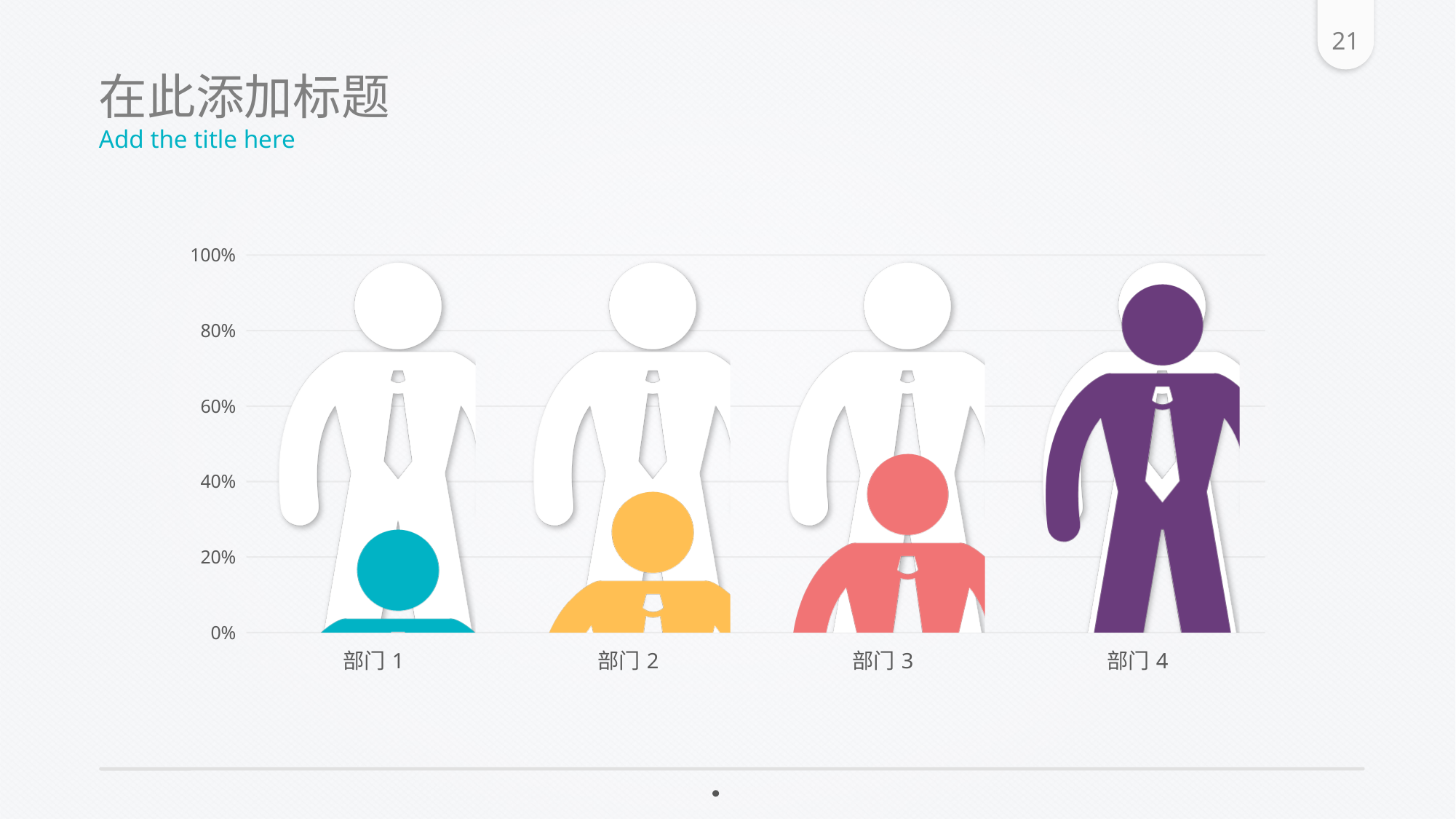
Is the value for 部门 3 greater or less than 20%? greater Which has the larger value, 部门 4 or 部门 2? 部门 4 What colour is the filled figure for 部门 4? purple Is the value for 部门 4 greater or less than 80%? greater Which category has the highest value in the chart? 部门 4 Is the value for 部门 2 greater or less than 60%? less Which category has the lowest value in the chart? 部门 1 How many categories are shown on the x axis of the chart? 4 What kind of chart is shown on the slide? bar chart Do the values rise or fall from 部门 1 to 部门 4 along the x axis? rise Which has the larger value, 部门 1 or 部门 3? 部门 3